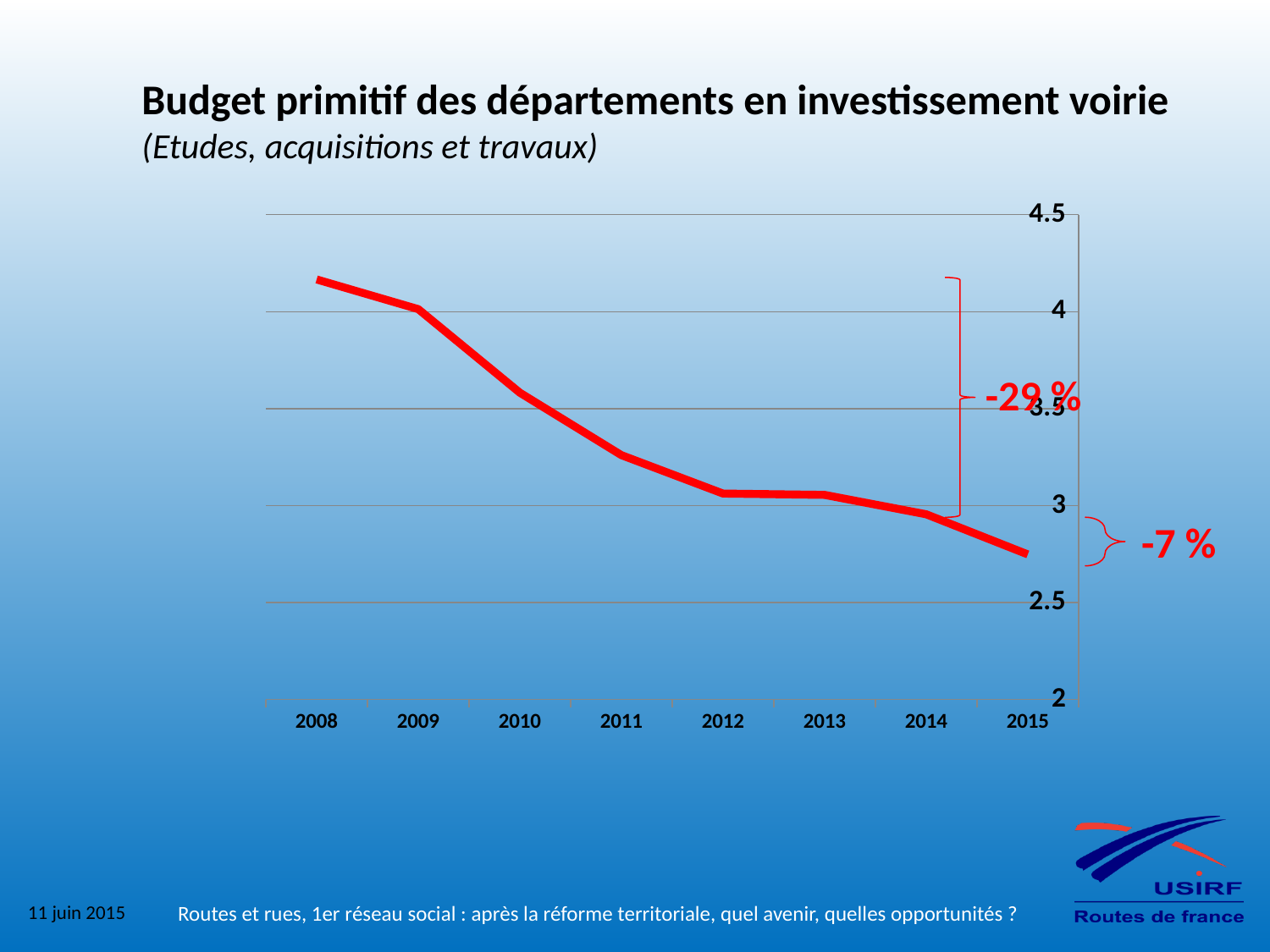
Do the values rise or fall from 2008 to 2015? fall Is the value for 2015 greater or less than 2.5? greater What percentage change is annotated for the drop from 2014 to 2015? -7 % What percentage change is annotated for the period from 2008 to 2014? -29 % Which year has the larger value, 2009 or 2011? 2009 Is the value for 2008 greater or less than 4? greater Which year has the highest value on the chart? 2008 How many years are plotted along the x axis? 8 Is the value for 2015 greater or less than 3? less Which year has the lowest value on the chart? 2015 What kind of chart is shown on the slide? line chart